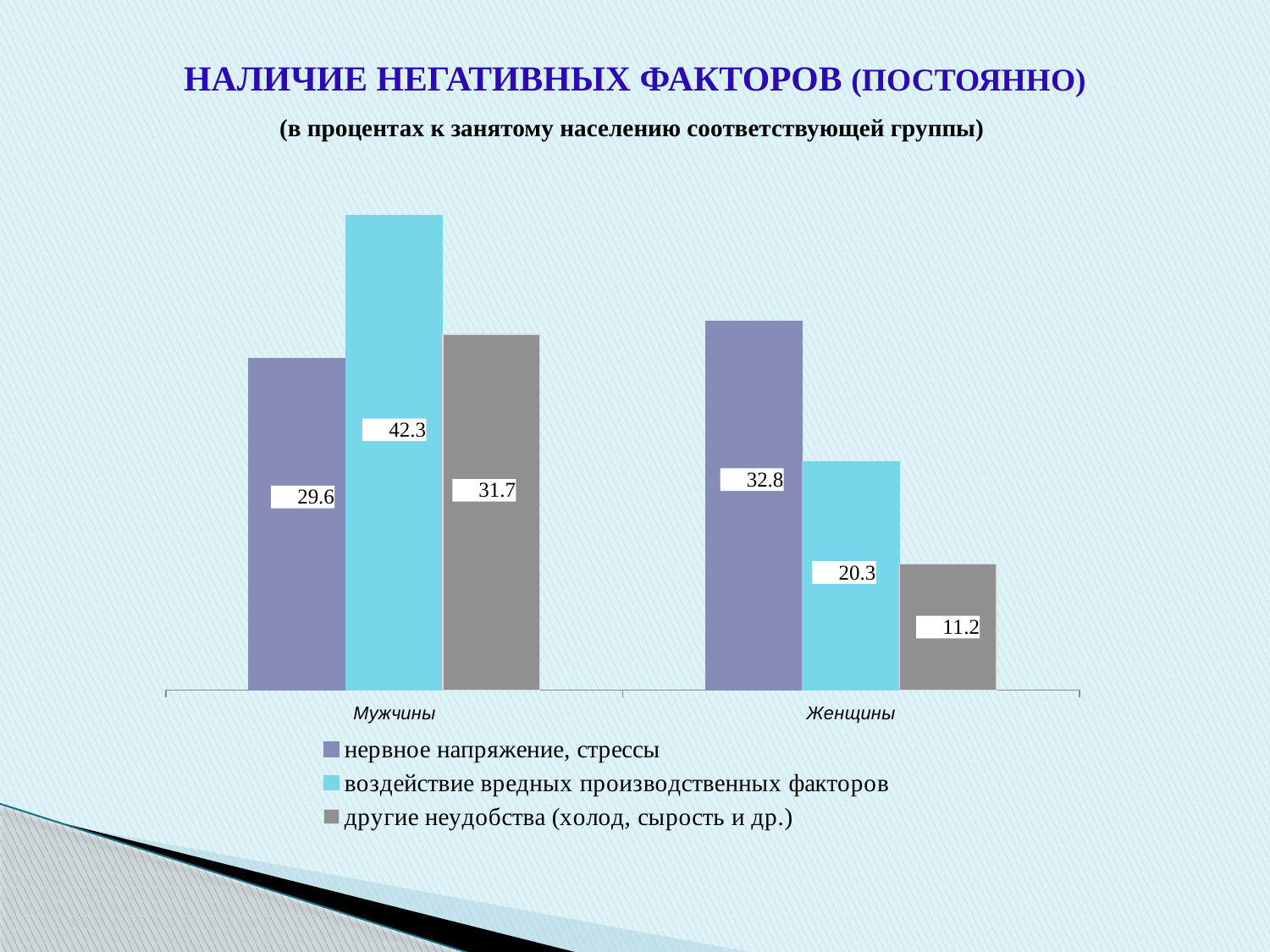
Which series has the lowest value for Женщины? другие неудобства (холод, сырость и др.) What is the value for 'воздействие вредных производственных факторов' for Мужчины? 42.3 What is the value for 'нервное напряжение, стрессы' for Мужчины? 29.6 What is the difference between the 'воздействие вредных производственных факторов' values for Мужчины and Женщины? 22.0 What kind of chart is shown on the slide? bar chart What is the value for 'другие неудобства (холод, сырость и др.)' for Женщины? 11.2 What is the difference between the 'другие неудобства (холод, сырость и др.)' values for Мужчины and Женщины? 20.5 How many series does the legend list? 3 Which series has the highest value for Мужчины? воздействие вредных производственных факторов Which group has the larger value for 'нервное напряжение, стрессы', Мужчины or Женщины? Женщины How many categories are shown on the x axis? 2 What is the value for 'нервное напряжение, стрессы' for Женщины? 32.8